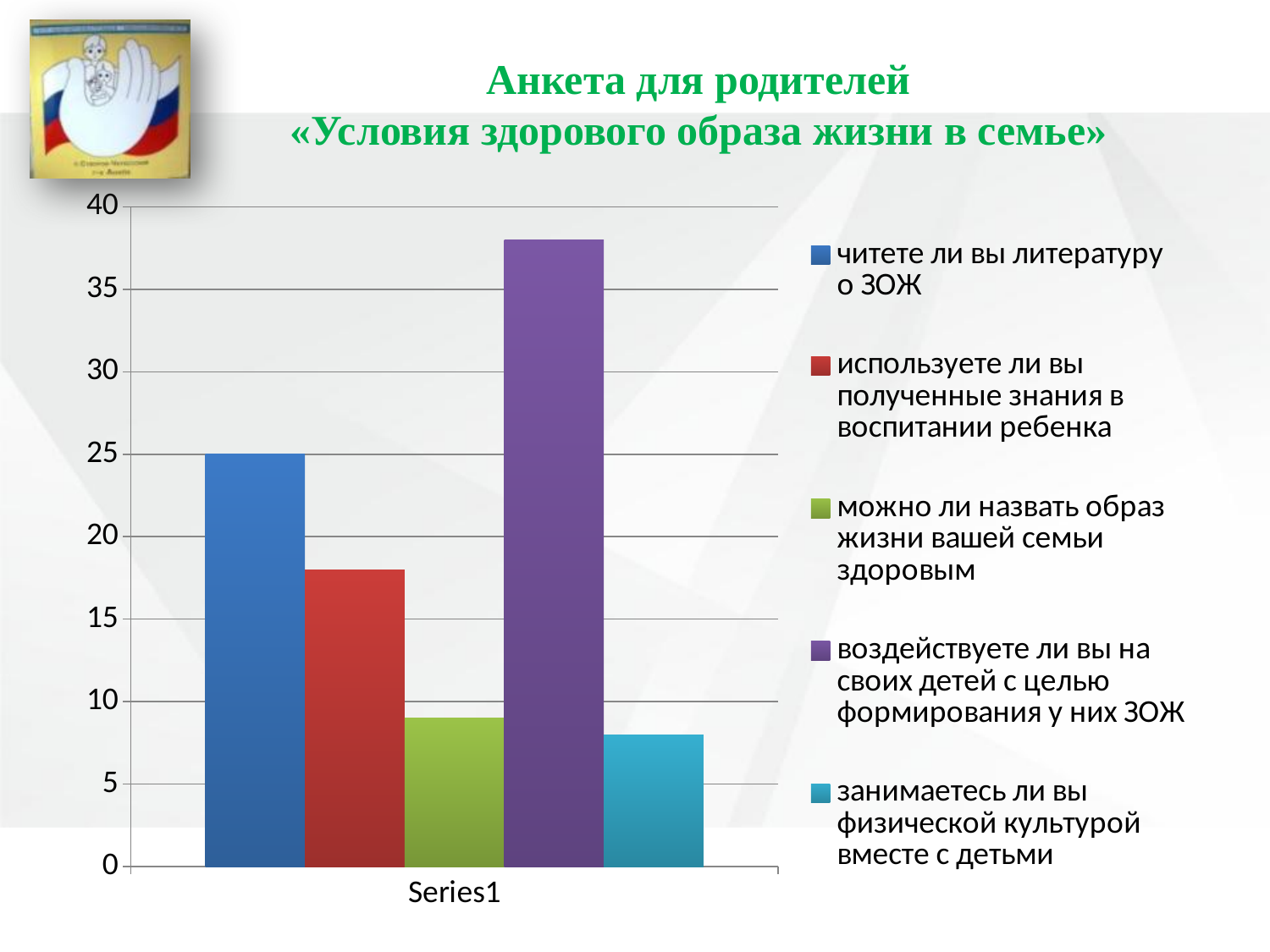
Is the value for «занимаетесь ли вы физической культурой вместе с детьми» greater or less than 10? less What is the value of the bar for «читете ли вы литературу о ЗОЖ»? 25 Is the value for «можно ли назвать образ жизни вашей семьи здоровым» greater or less than 10? less What label is shown on the horizontal axis of the chart? Series1 Is the value for «воздействуете ли вы на своих детей с целью формирования у них ЗОЖ» greater or less than 35? greater How many bars are plotted in the chart? 5 How many entries does the legend list? 5 Which is larger: the bar for «читете ли вы литературу о ЗОЖ» or the bar for «используете ли вы полученные знания в воспитании ребенка»? читете ли вы литературу о ЗОЖ What kind of chart is shown on the slide? bar chart Which legend entry has the highest bar? воздействуете ли вы на своих детей с целью формирования у них ЗОЖ